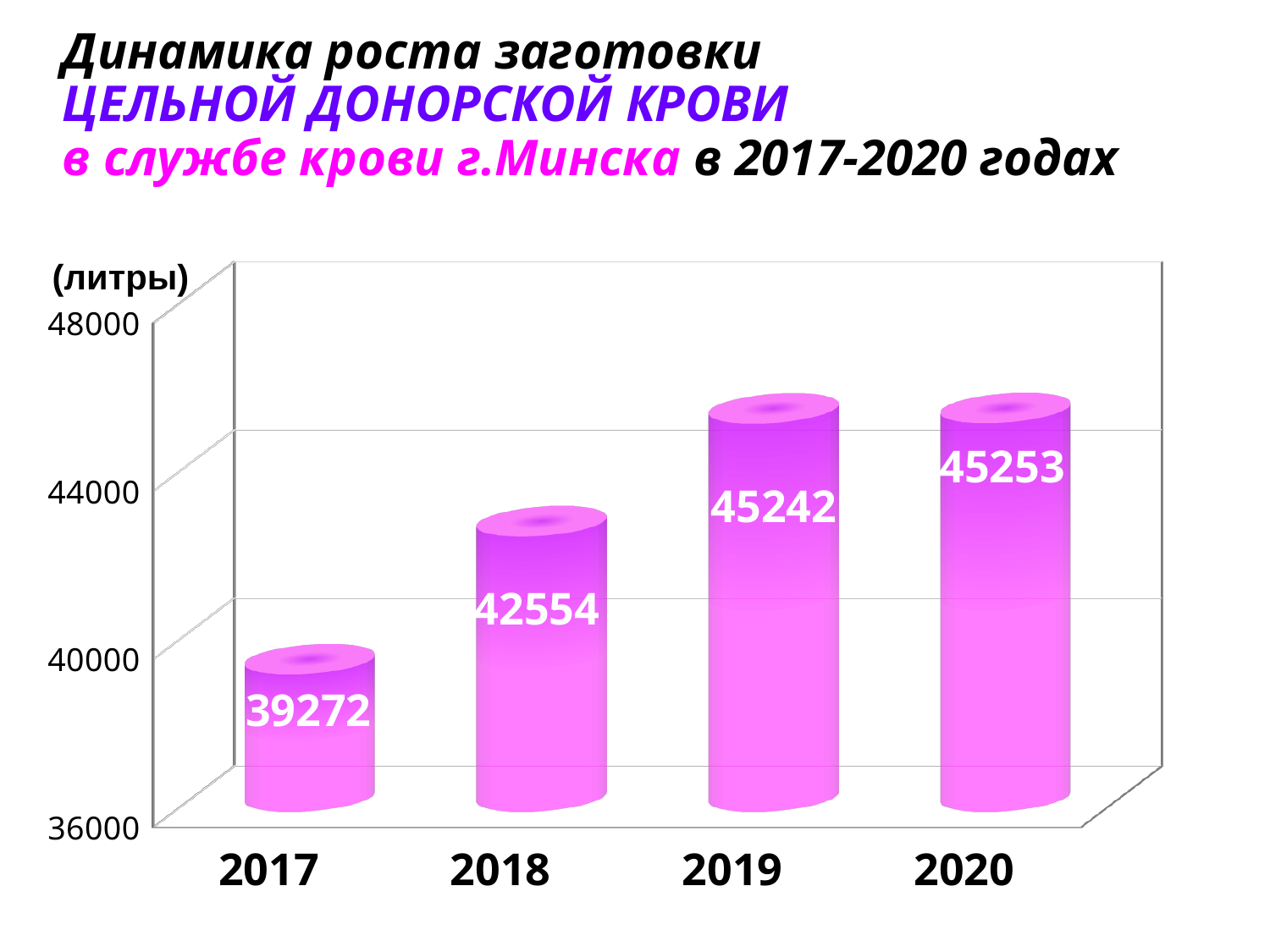
What is the difference between the values for 2020 and 2017? 5981 Is the value for 2017 greater or less than 40000? less Which year has the lowest value? 2017 What is the value for 2019? 45242 What is the value for 2017? 39272 What is the value for 2020? 45253 What kind of chart is shown on the slide? bar chart What is the value for 2018? 42554 Which is larger, the value for 2018 or the value for 2019? 2019 What is the difference between the values for 2018 and 2017? 3282 How many years are shown on the x axis? 4 Which year has the highest value? 2020